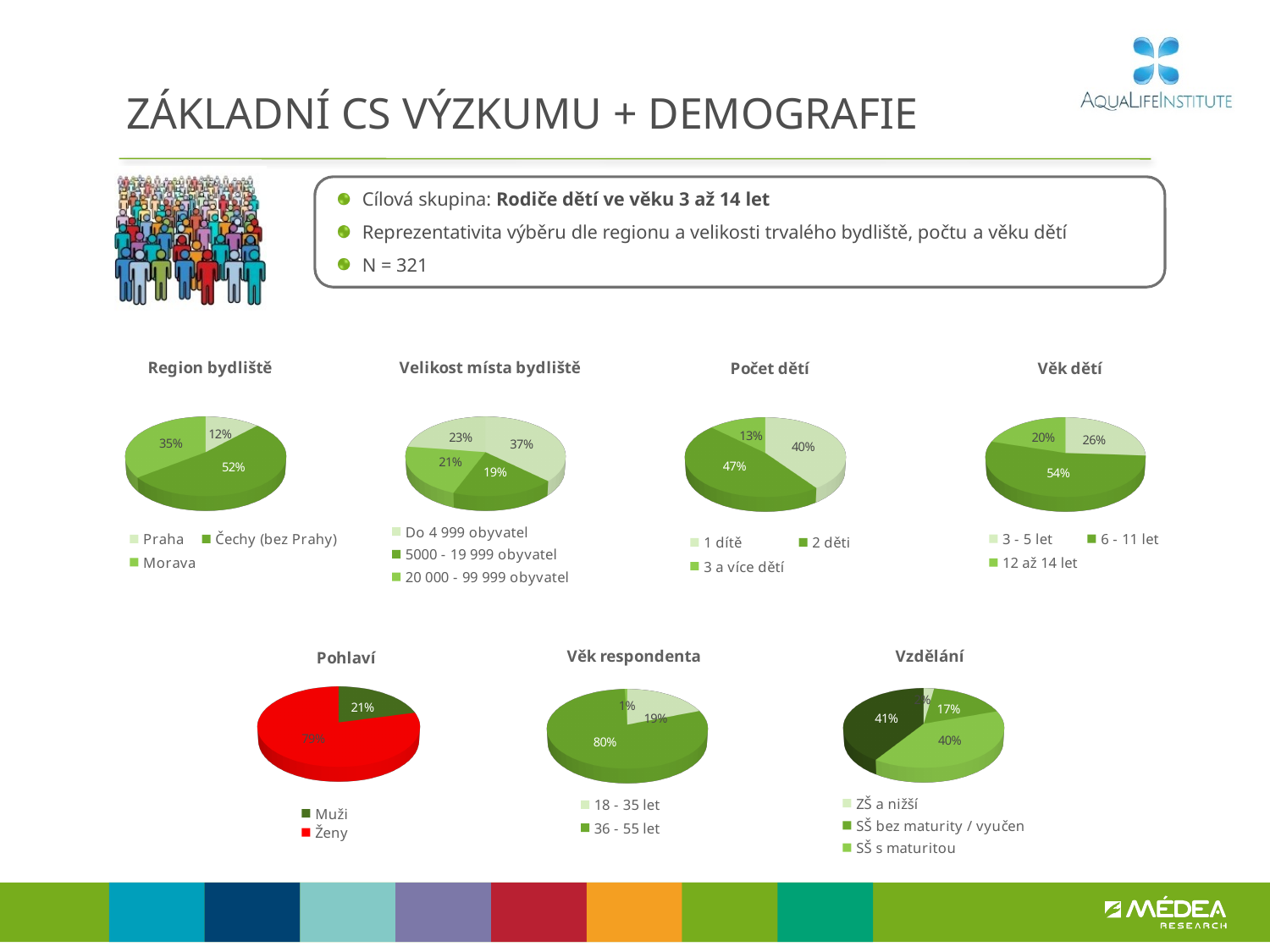
In the 'Vzdělání' pie chart, what is the largest percentage shown? 41% In the 'Počet dětí' pie chart, what percentage is shown for '2 děti'? 47% In the 'Věk dětí' pie chart, which category has the smallest share? 12 až 14 let In the 'Věk respondenta' pie chart, what is the difference between the '36 - 55 let' and '18 - 35 let' shares? 61% In the 'Region bydliště' pie chart, what percentage is shown for Praha? 12% In the 'Věk dětí' pie chart, what percentage is shown for '6 - 11 let'? 54% What type of chart is used for 'Počet dětí'? Pie chart In the 'Pohlaví' pie chart, what percentage is shown for Muži? 21% In the 'Region bydliště' pie chart, what is the largest slice's value? 52% In the 'Věk respondenta' pie chart, what percentage is shown for '36 - 55 let'? 80% In the 'Velikost místa bydliště' pie chart, what is the largest percentage shown? 37% In the 'Počet dětí' pie chart, what percentage is shown for '3 a více dětí'? 13%